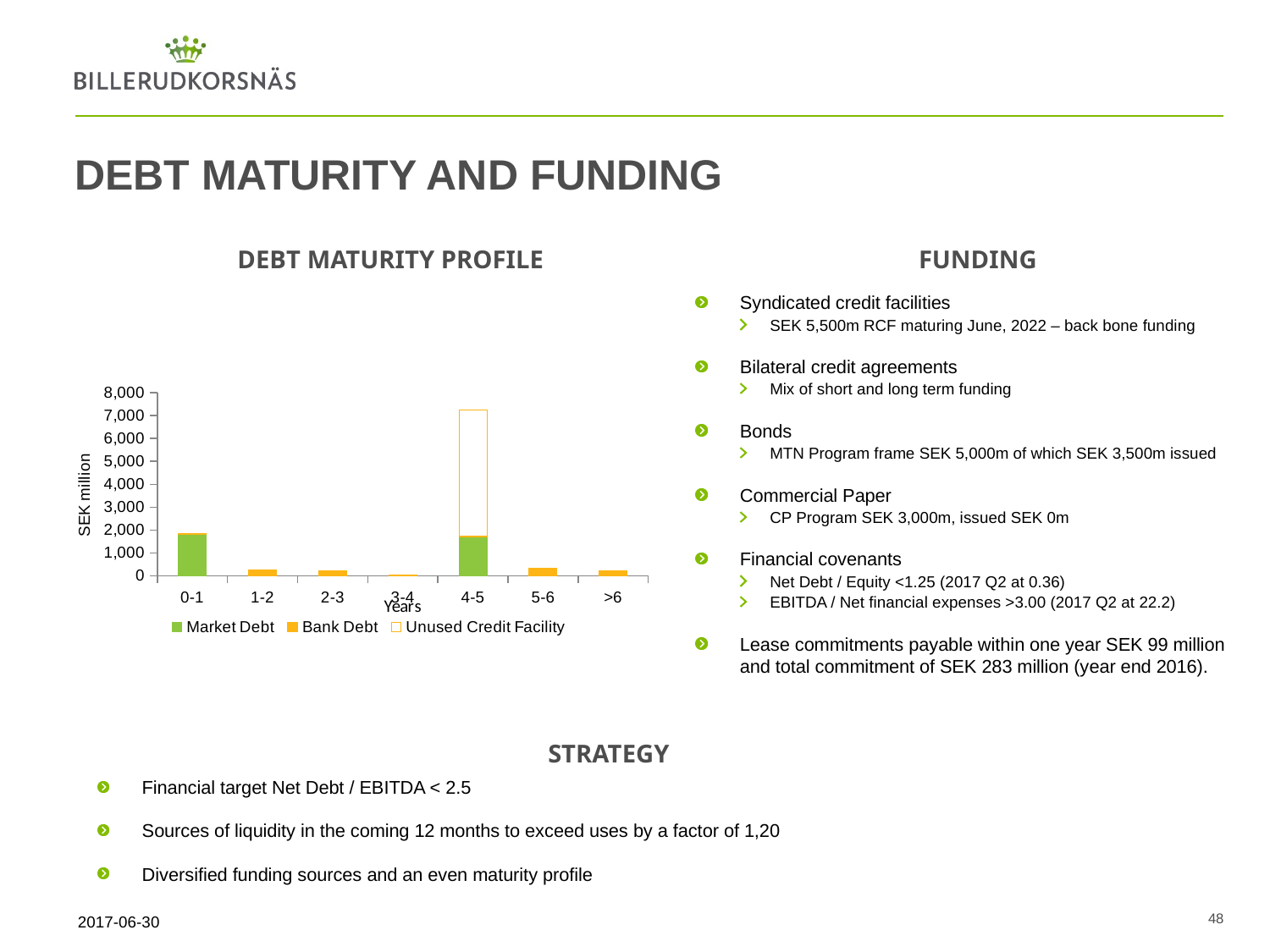
In the Debt Maturity Profile chart, is the total bar for 0-1 years greater or less than 2,000? less How many series does the legend of the Debt Maturity Profile chart list? 3 Which maturity category has the smallest bar in the Debt Maturity Profile chart? 3-4 In the Debt Maturity Profile chart, which bar is taller: 0-1 years or 1-2 years? 0-1 Which maturity category has the tallest bar in the Debt Maturity Profile chart? 4-5 In the Debt Maturity Profile chart, is the total bar for 4-5 years greater or less than 6,000? greater Which series in the Debt Maturity Profile chart is shown as an unfilled (white) bar? Unused Credit Facility How many maturity categories are shown on the x axis of the Debt Maturity Profile chart? 7 In the Debt Maturity Profile chart, is the bar for 1-2 years greater or less than 1,000? less What is the label of the vertical axis in the Debt Maturity Profile chart? SEK million What kind of chart is the Debt Maturity Profile chart? bar chart